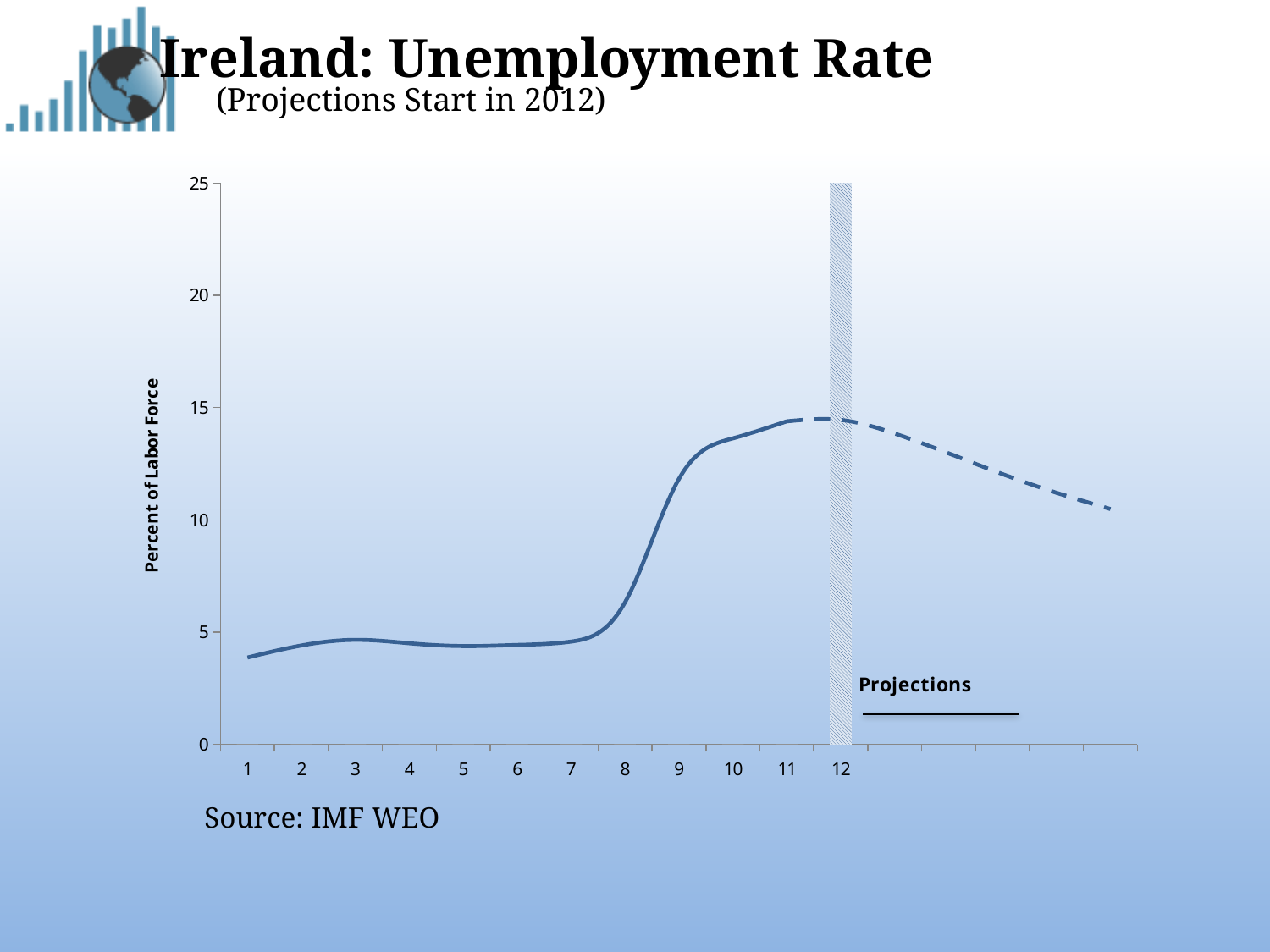
What is the label on the vertical axis? Percent of Labor Force What kind of chart is shown on the slide? line chart Is the value for year 9 greater or less than 10? greater Is the value for year 11 greater or less than 10? greater What is the title of the chart? Ireland: Unemployment Rate Is the value for year 1 greater or less than 5? less Which is larger, the value for year 8 or the value for year 9? year 9 Which is larger, the value for year 3 or the value for year 10? year 10 Does the unemployment rate rise or fall between year 8 and year 11? rise Does the projected unemployment rate rise or fall after year 12? fall